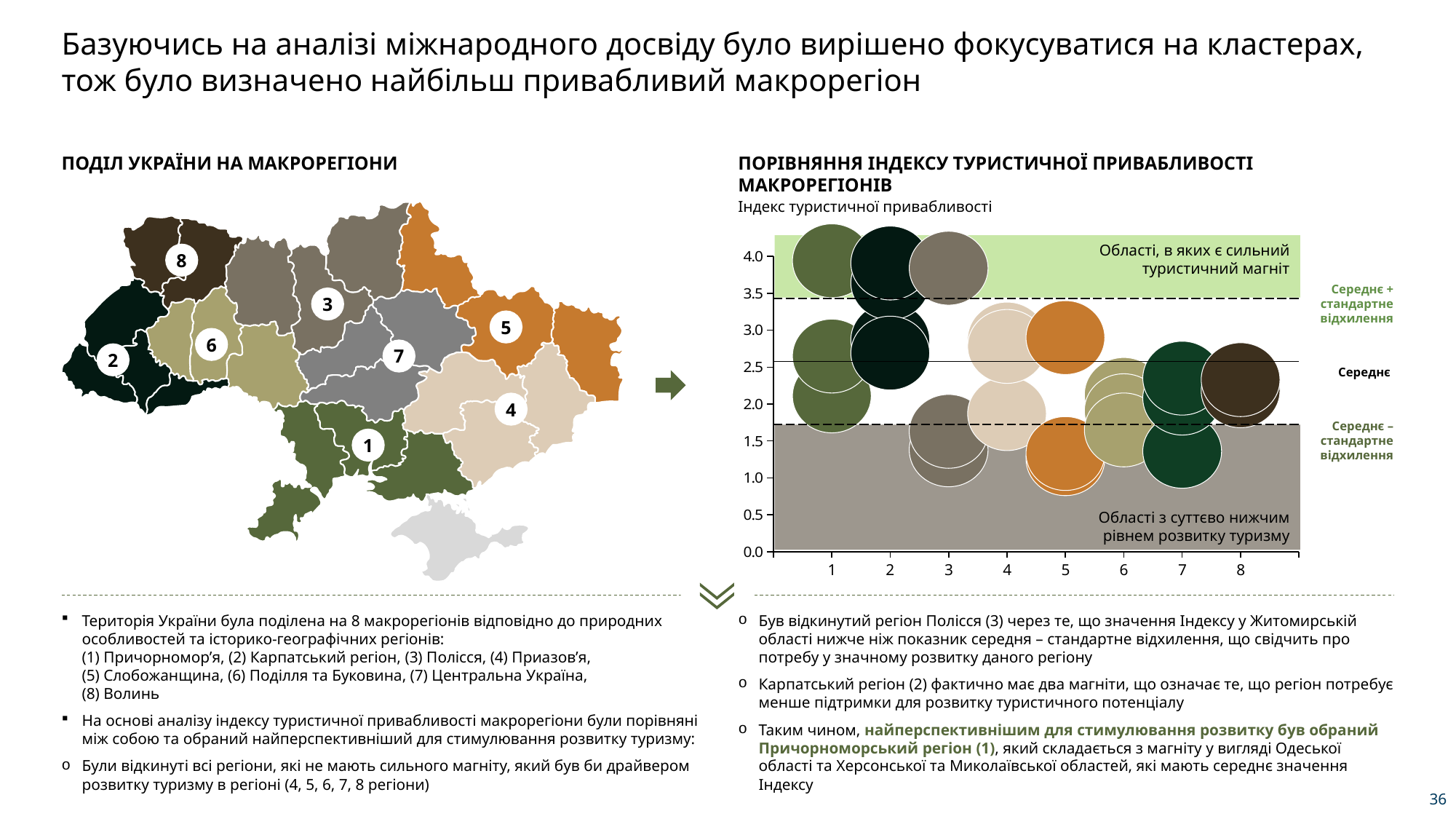
In the bubble chart on the right, is the value of the single bubble for macroregion 8 greater or less than 3.0? less In the bubble chart on the right, what label is given to the solid horizontal line in the middle of the chart? Середнє In the bubble chart on the right, is the highest bubble for macroregion 2 greater or less than 3.5? greater In the bubble chart on the right, is the highest bubble for macroregion 1 greater or less than 3.5? greater In the bubble chart on the right, how many macroregions are marked along the x axis? 8 What kind of chart is shown under the title 'ПОРІВНЯННЯ ІНДЕКСУ ТУРИСТИЧНОЇ ПРИВАБЛИВОСТІ МАКРОРЕГІОНІВ'? Bubble chart In the bubble chart on the right, what is the highest value shown on the y axis? 4.0